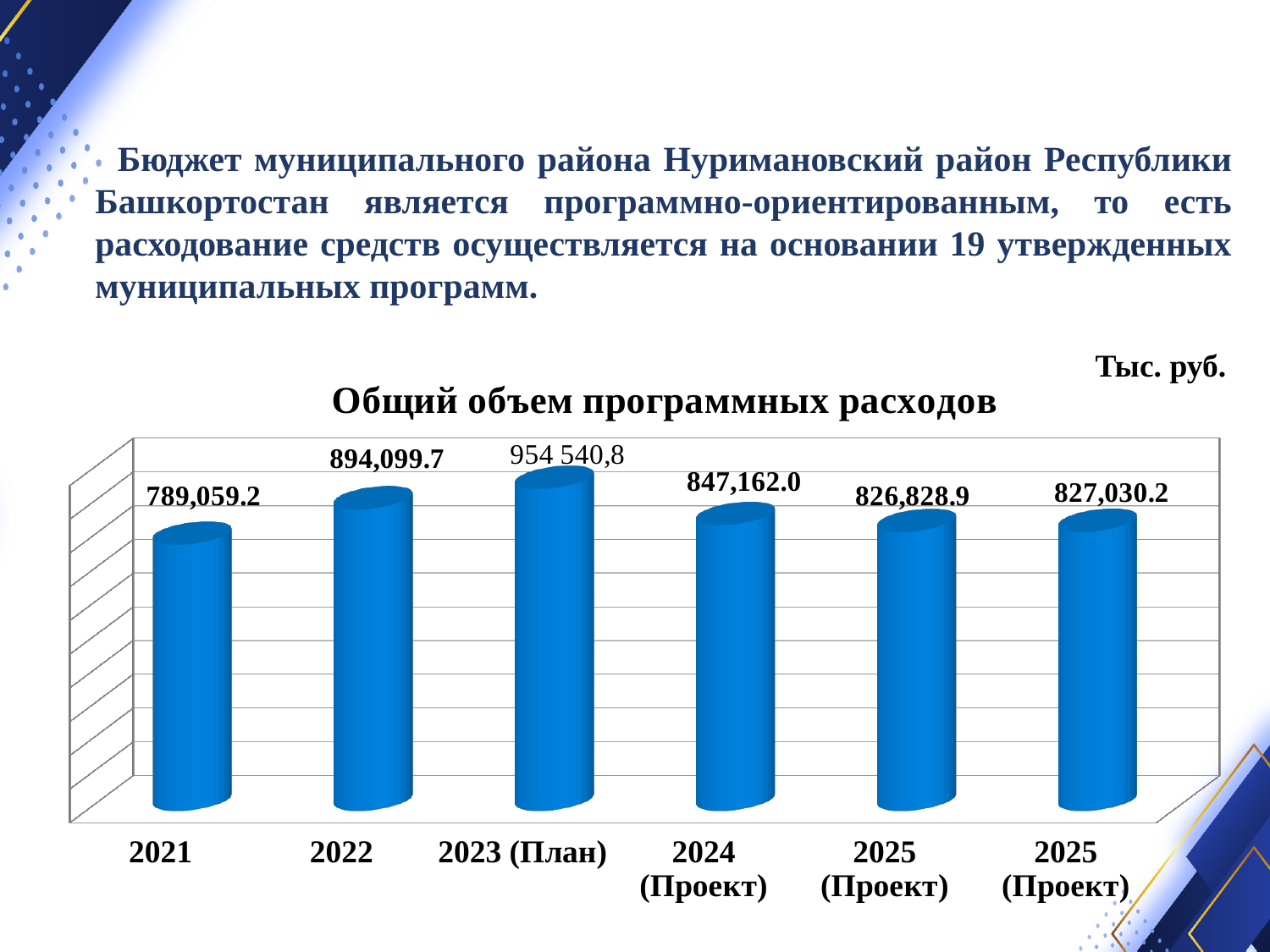
What kind of chart is shown on the slide? Bar chart What is the value for 2022 in the chart? 894,099.7 What is the value for 2021 in the chart "Общий объем программных расходов"? 789,059.2 Do the values rise or fall from 2021 to 2023 (План)? Rise Which category has the lowest value in the chart? 2021 What is the difference between the values for 2022 and 2021? 105,040.5 Which category has the highest value in the chart? 2023 (План) How many bars are shown in the chart? 6 What is the value for 2023 (План) in the chart? 954 540,8 Which is larger, the value for 2022 or the value for 2024 (Проект)? 2022 What is the difference between the value for 2024 (Проект) and the value of the fifth bar, 826,828.9? 20,333.1 What is the value for 2024 (Проект) in the chart? 847,162.0